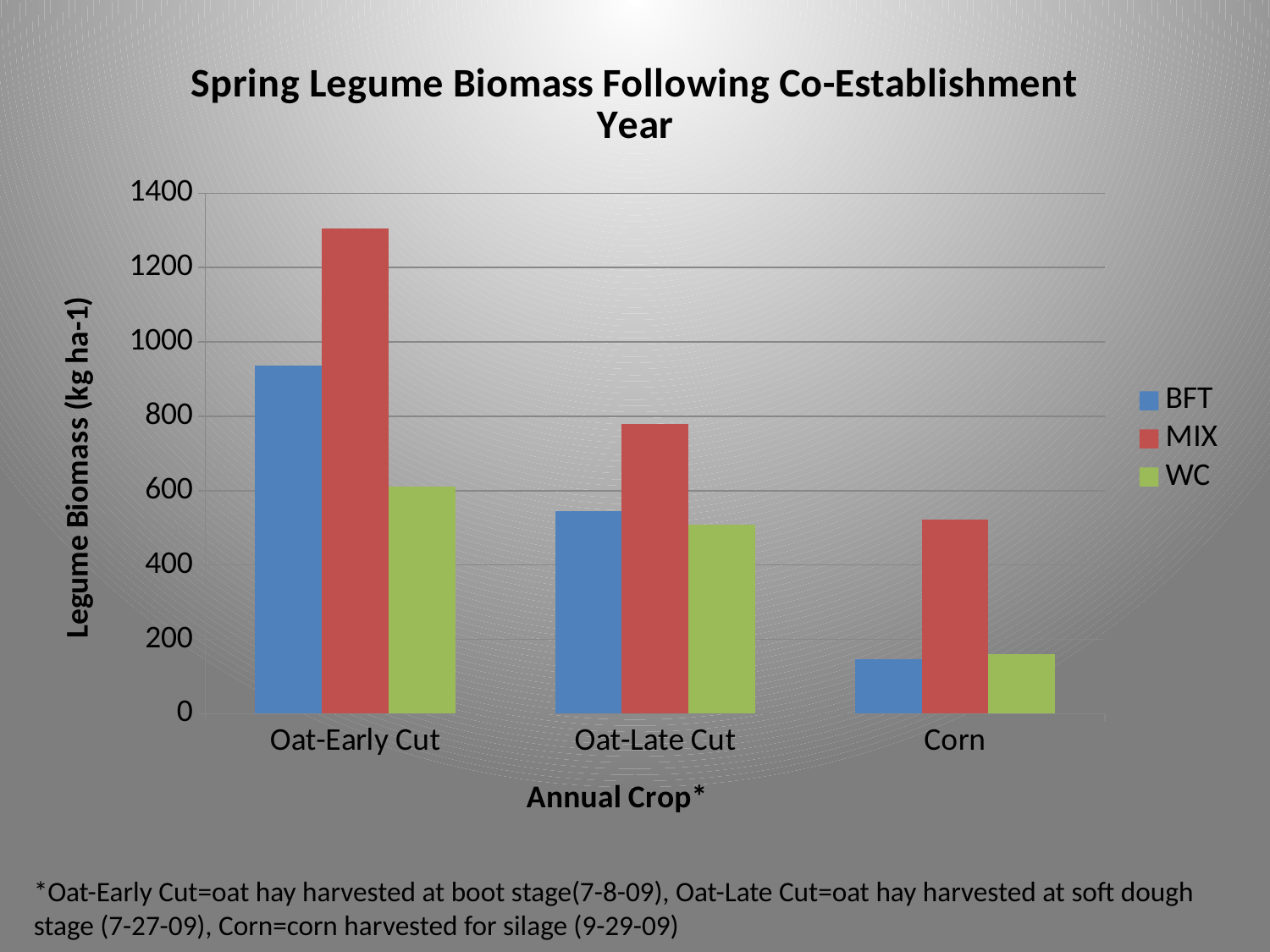
Which series has the lowest bar for Oat-Early Cut? WC Is the BFT value for Oat-Early Cut greater or less than 1000? less Which series has the highest bar for Oat-Early Cut? MIX How many series does the legend list? 3 Which is larger for Oat-Early Cut, the BFT value or the WC value? BFT Is the MIX value for Oat-Early Cut greater or less than 1200? greater What kind of chart is shown on the slide? bar chart Which series has the highest bar for Oat-Late Cut? MIX What is the title of the y axis? Legume Biomass (kg ha-1) How many annual crop categories are shown on the x axis? 3 Is the BFT value for Corn greater or less than 200? less Does the MIX series rise or fall from Oat-Early Cut to Corn? fall